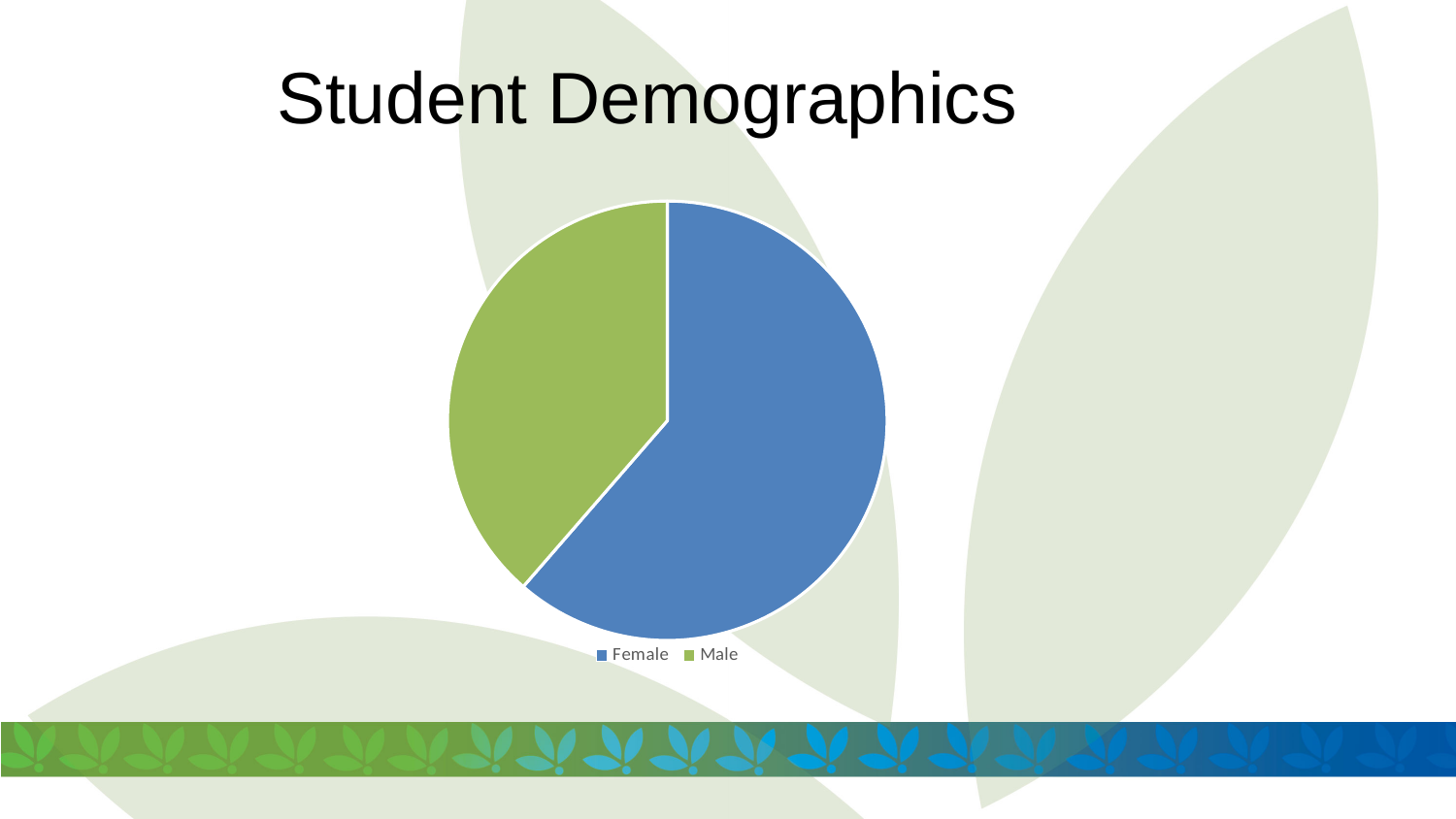
Which category has the smallest slice of the pie chart? Male How many slices does the pie chart have? 2 Which category has the largest slice of the pie chart? Female Does the Female slice take up more or less than half of the pie? more What colour is the Male slice in the pie chart? green What kind of chart is shown on the slide? pie chart What is the title of the slide containing the pie chart? Student Demographics Which slice is larger, Female or Male? Female How many entries does the legend of the pie chart list? 2